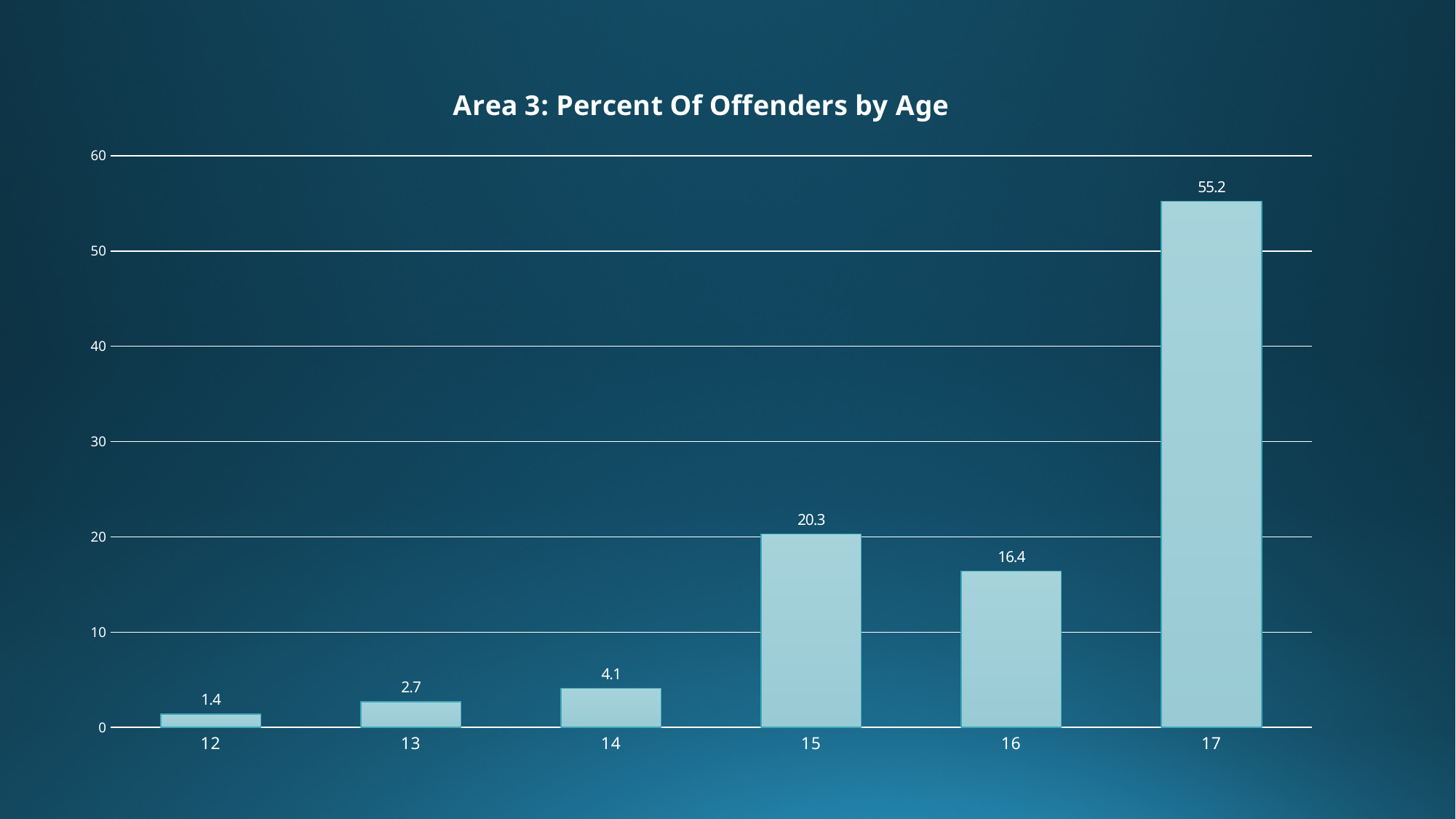
What is the difference between the values for age 16 and age 14? 12.3 How many age categories are shown on the chart? 6 What kind of chart is shown on the slide? bar chart What is the difference between the values for age 17 and age 15? 34.9 Which is larger, the value for age 15 or the value for age 16? 15 What is the value for age 12? 1.4 Which age has the highest value? 17 Is the value for age 17 greater or less than 50? greater Which age has the lowest value? 12 What is the value for age 15? 20.3 What is the title of the chart? Area 3: Percent Of Offenders by Age What is the value for age 17? 55.2